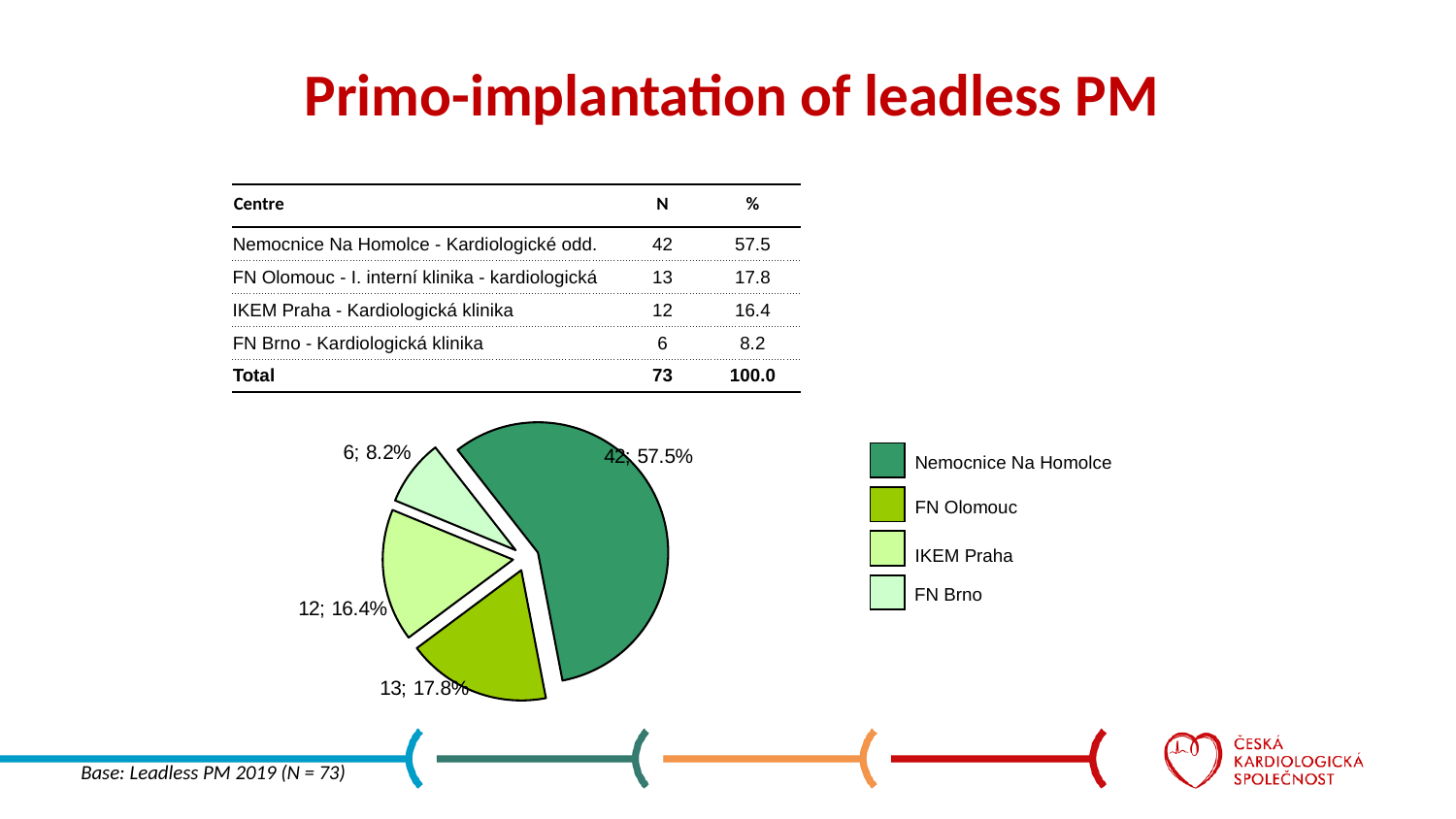
Which legend entry is shown in the darkest green colour? Nemocnice Na Homolce How many slices does the pie chart have? 4 What is the count (N) shown for IKEM Praha in the pie chart? 12 Which centre has the smallest slice of the pie? FN Brno What is the difference in count between Nemocnice Na Homolce and FN Olomouc? 29 Which has a larger share of the pie, FN Olomouc or IKEM Praha? FN Olomouc How many entries does the pie chart legend list? 4 What kind of chart is shown on the slide? pie chart What share of the pie does FN Brno hold? 8.2% What is the count (N) shown for FN Olomouc in the pie chart? 13 Which centre has the largest slice of the pie? Nemocnice Na Homolce What share of the pie does Nemocnice Na Homolce hold? 57.5%